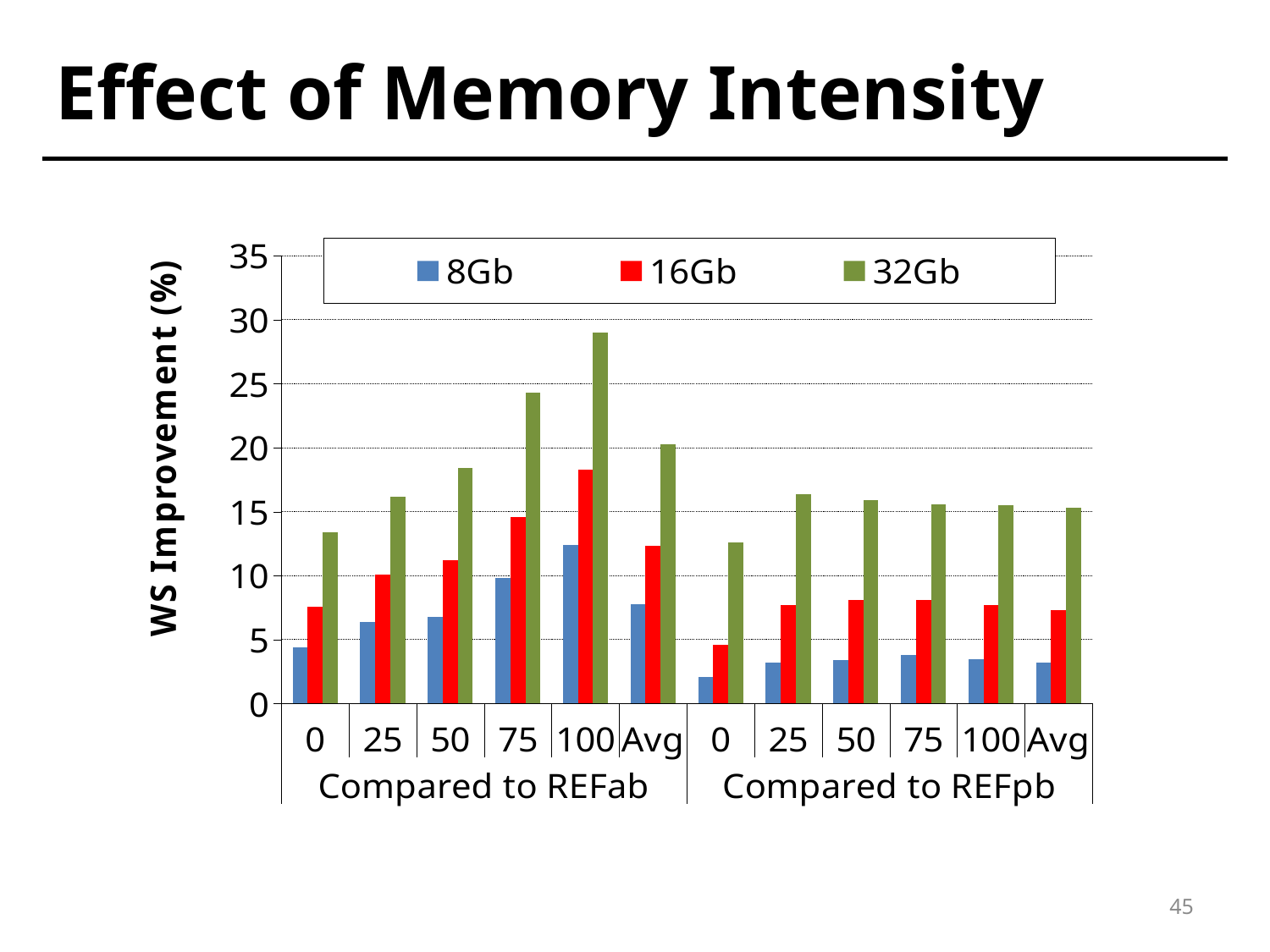
Do the 8Gb values under "Compared to REFab" rise or fall from 0 to 100? rise Is the 32Gb value at 100 under "Compared to REFab" greater or less than 25? greater What is the title of the y axis? WS Improvement (%) What kind of chart is shown on the slide? bar chart Which bar is the lowest in the whole chart? 8Gb at 0, Compared to REFpb Is the 16Gb value at 100 under "Compared to REFab" greater or less than 15? greater What colour represents the 16Gb series in the legend? red How many series does the legend list? 3 Which bar is the highest in the whole chart? 32Gb at 100, Compared to REFab How many memory-intensity categories are shown under "Compared to REFab"? 6 Which is larger: the 32Gb value at 75 under "Compared to REFab" or the 32Gb value at 75 under "Compared to REFpb"? Compared to REFab Is the 8Gb value at 0 under "Compared to REFpb" greater or less than 5? less